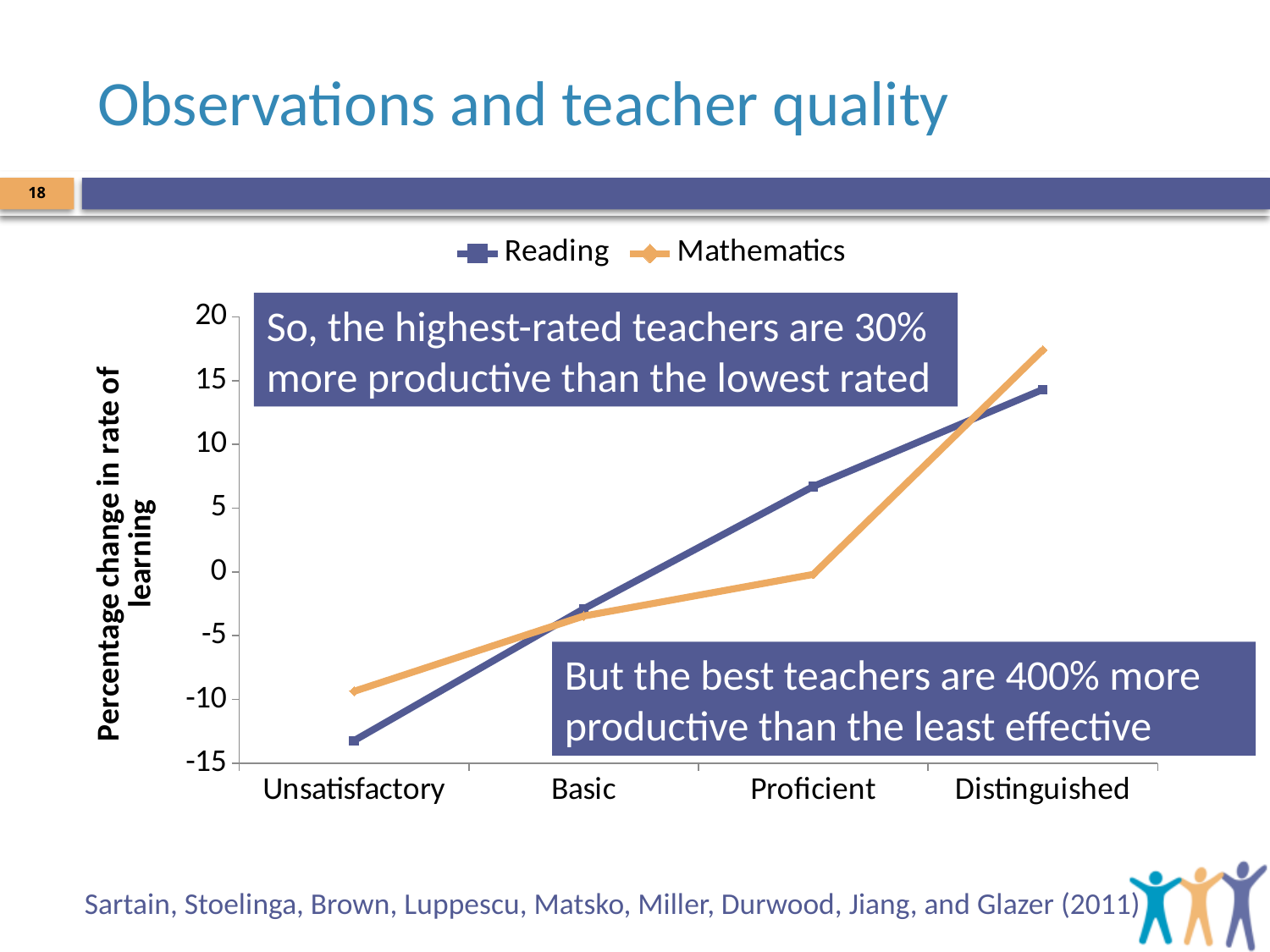
Do the Reading values rise or fall from Unsatisfactory to Distinguished? rise Is the Reading value for Unsatisfactory greater or less than -10? less What is the label of the vertical axis? Percentage change in rate of learning Which series are listed in the legend? Reading and Mathematics How many series does the legend list? 2 What kind of chart is shown on the slide? line chart How many rating categories are shown on the x axis? 4 At which rating category is the Reading series highest? Distinguished Is the Reading value for Proficient greater or less than 5? greater Is the Mathematics value for Distinguished greater or less than 15? greater At Distinguished, which series has the higher value, Reading or Mathematics? Mathematics At which rating category is the Mathematics series lowest? Unsatisfactory